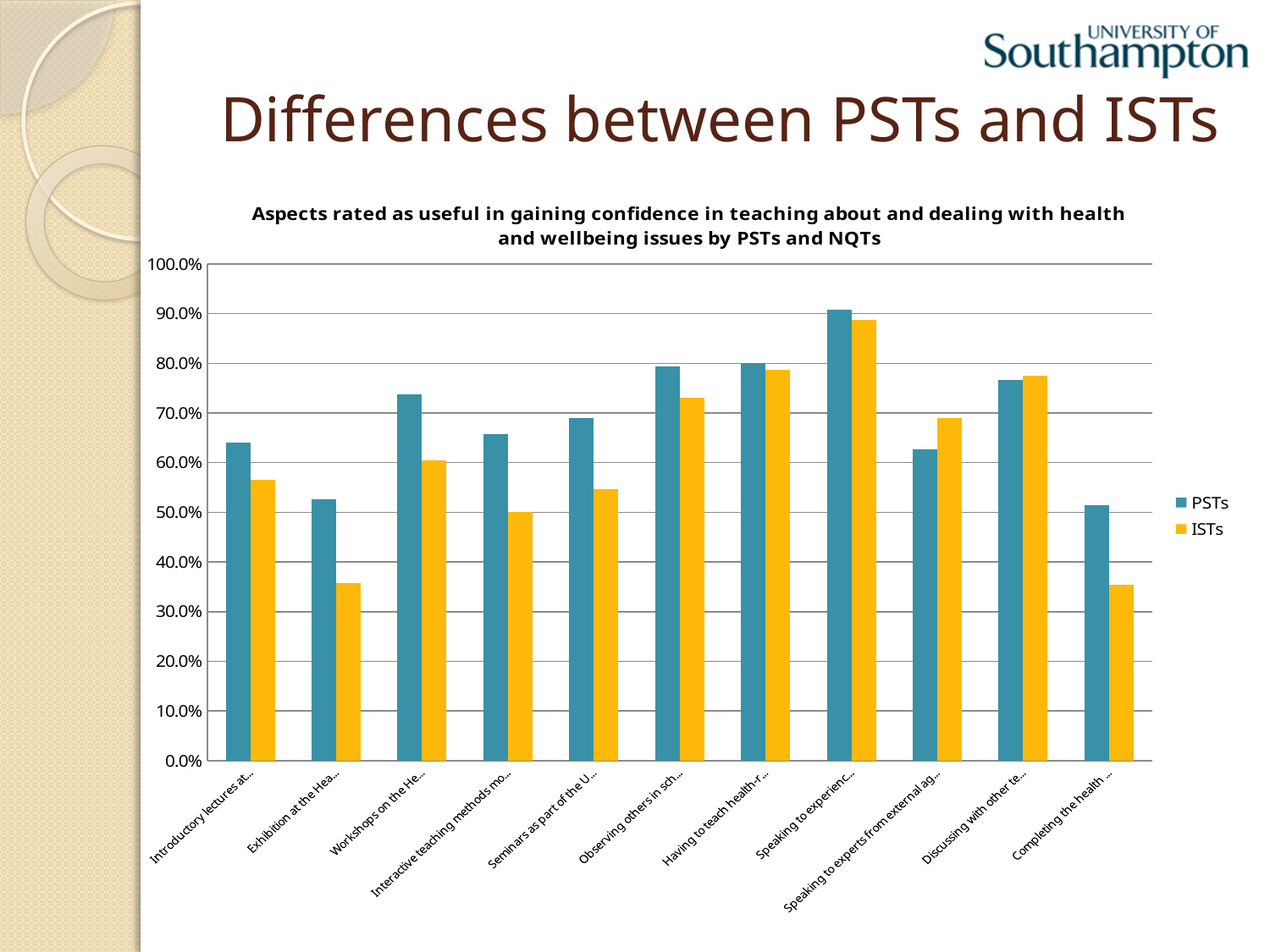
Which colour represents the ISTs series in the chart? yellow Which category has the highest PSTs value? Speaking to experienc... How many categories are plotted along the x axis? 11 For 'Exhibition at the Hea...', which series has the larger value, PSTs or ISTs? PSTs Is the PSTs value for 'Speaking to experienc...' greater or less than 80.0%? greater What kind of chart is shown on the slide? bar chart Is the ISTs value for 'Exhibition at the Hea...' greater or less than 40.0%? less What is the maximum value shown on the y axis? 100.0% For 'Speaking to experts from external ag...', which series has the larger value, PSTs or ISTs? ISTs Is the PSTs value for 'Workshops on the He...' greater or less than 70.0%? greater How many series does the legend list? 2 Which category has the highest ISTs value? Speaking to experienc...